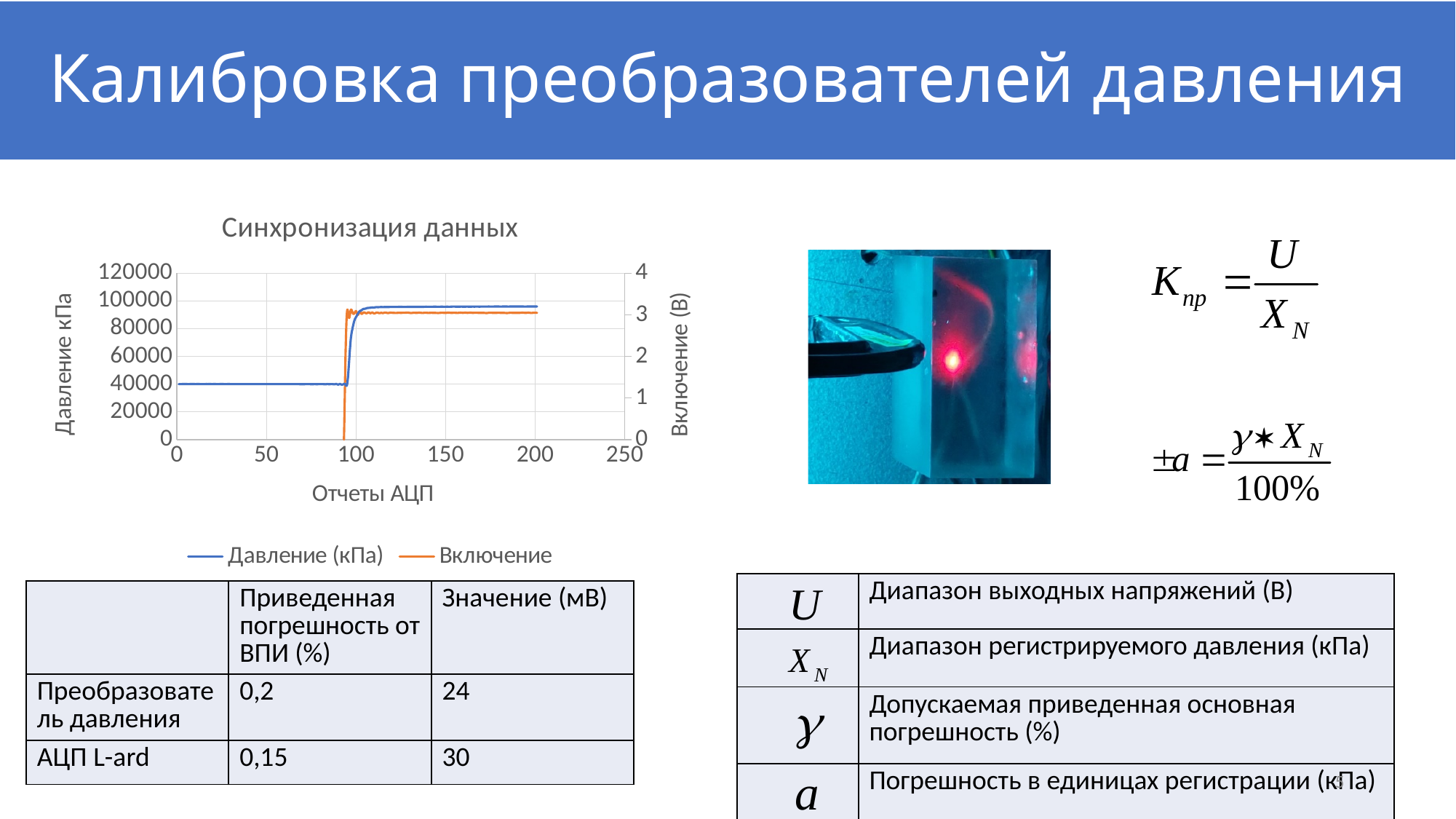
Is the value of Давление (кПа) at x = 150 greater or less than 80000? greater Does the Давление (кПа) series rise or fall overall along the x axis? rise Is the value of Включение at x = 150 greater or less than 2? greater What is the title of the chart? Синхронизация данных Does the Включение series rise or fall overall along the x axis? rise Is the value of Давление (кПа) at x = 200 greater or less than 100000? less What kind of chart is shown on the slide? line chart What is the label of the x axis of the chart? Отчеты АЦП How many series does the chart legend list? 2